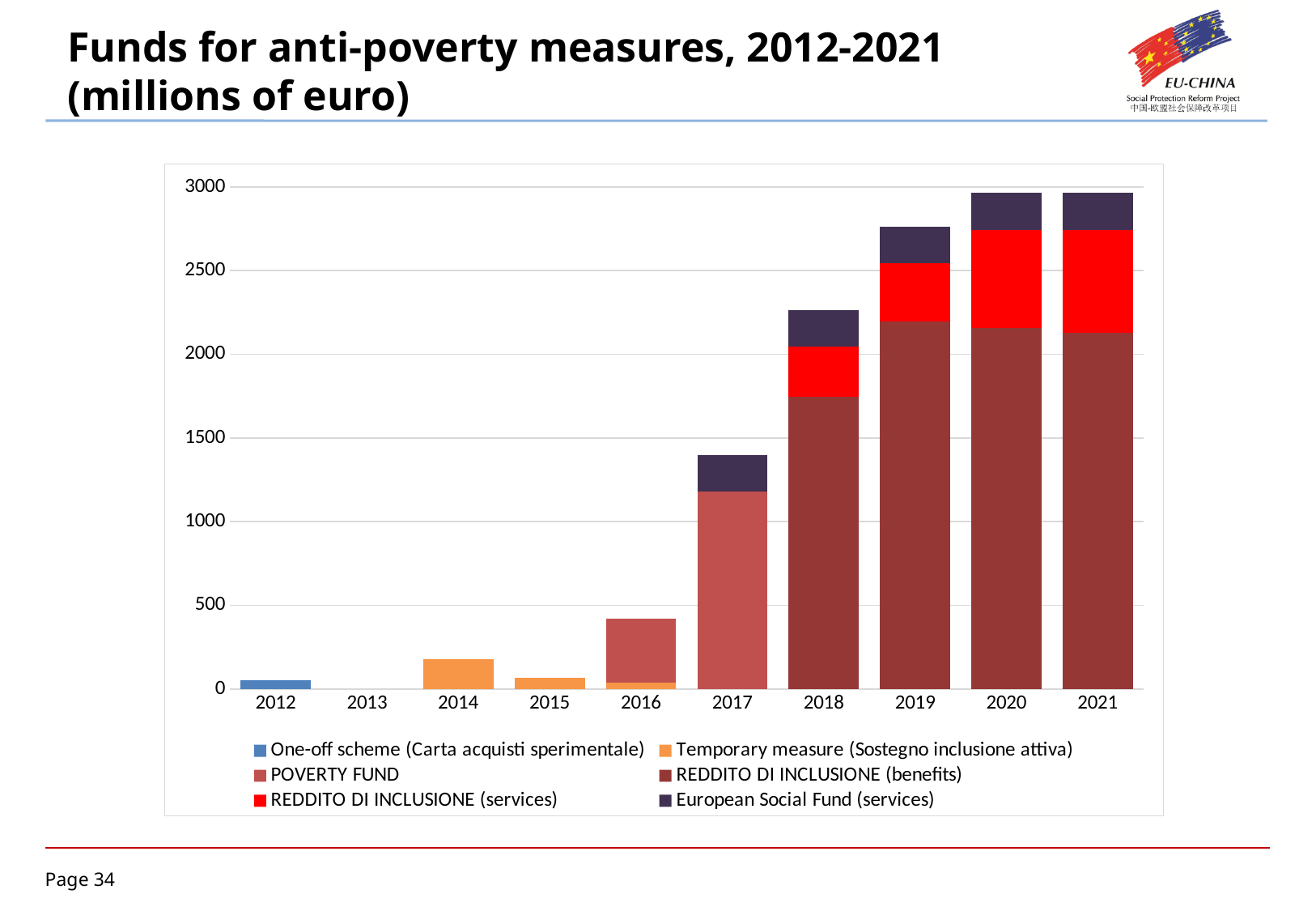
Is the total value for 2019 greater or less than 2500? greater What kind of chart is shown on the slide? Stacked bar chart Which series is the only one plotted for 2012? One-off scheme (Carta acquisti sperimentale) Is the total value for 2018 greater or less than 2000? greater Is the total value for 2016 greater or less than 500? less How many years are shown on the x axis of the chart? 10 Which year has the larger total, 2017 or 2018? 2018 Which year has the larger total, 2014 or 2015? 2014 How many series does the chart's legend list? 6 Which year shows no funding bar at all? 2013 Do the total funds rise or fall from 2016 to 2020? rise